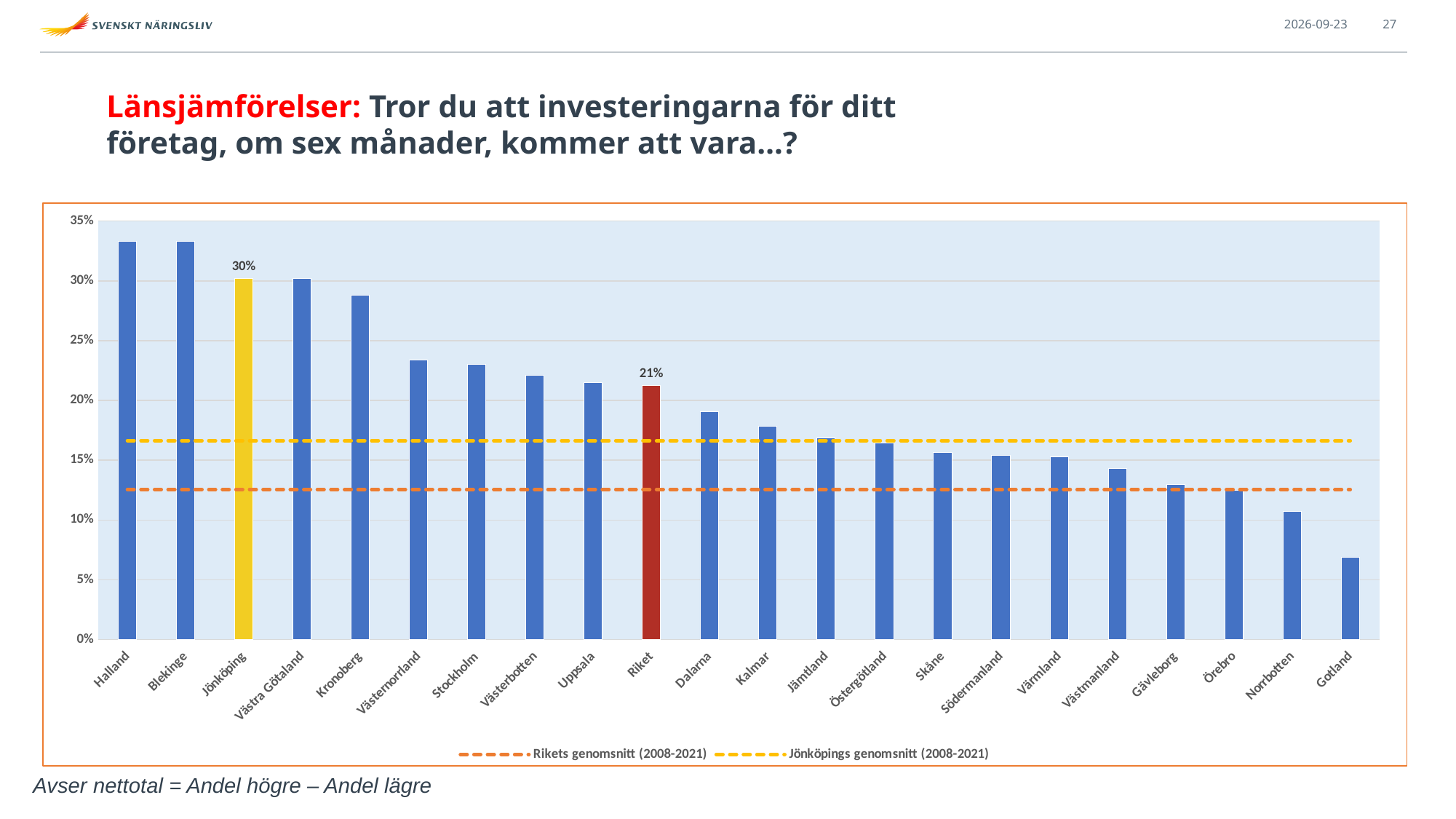
Is the value for Gotland greater or less than 10%? less Which category has the lowest bar? Gotland What value is shown for Jönköping? 30% Do the bar values rise or fall from left to right along the x axis? Fall How many categories are shown on the x axis? 22 What is the difference between the labelled values for Jönköping and Riket? 9 percentage points Is the value for Kronoberg greater or less than 25%? greater How many entries does the legend list? 2 Is the value for Örebro greater or less than 15%? less What value is shown for Riket? 21% Which is larger, the value for Jönköping or the value for Riket? Jönköping What kind of chart is shown on the slide? Bar chart